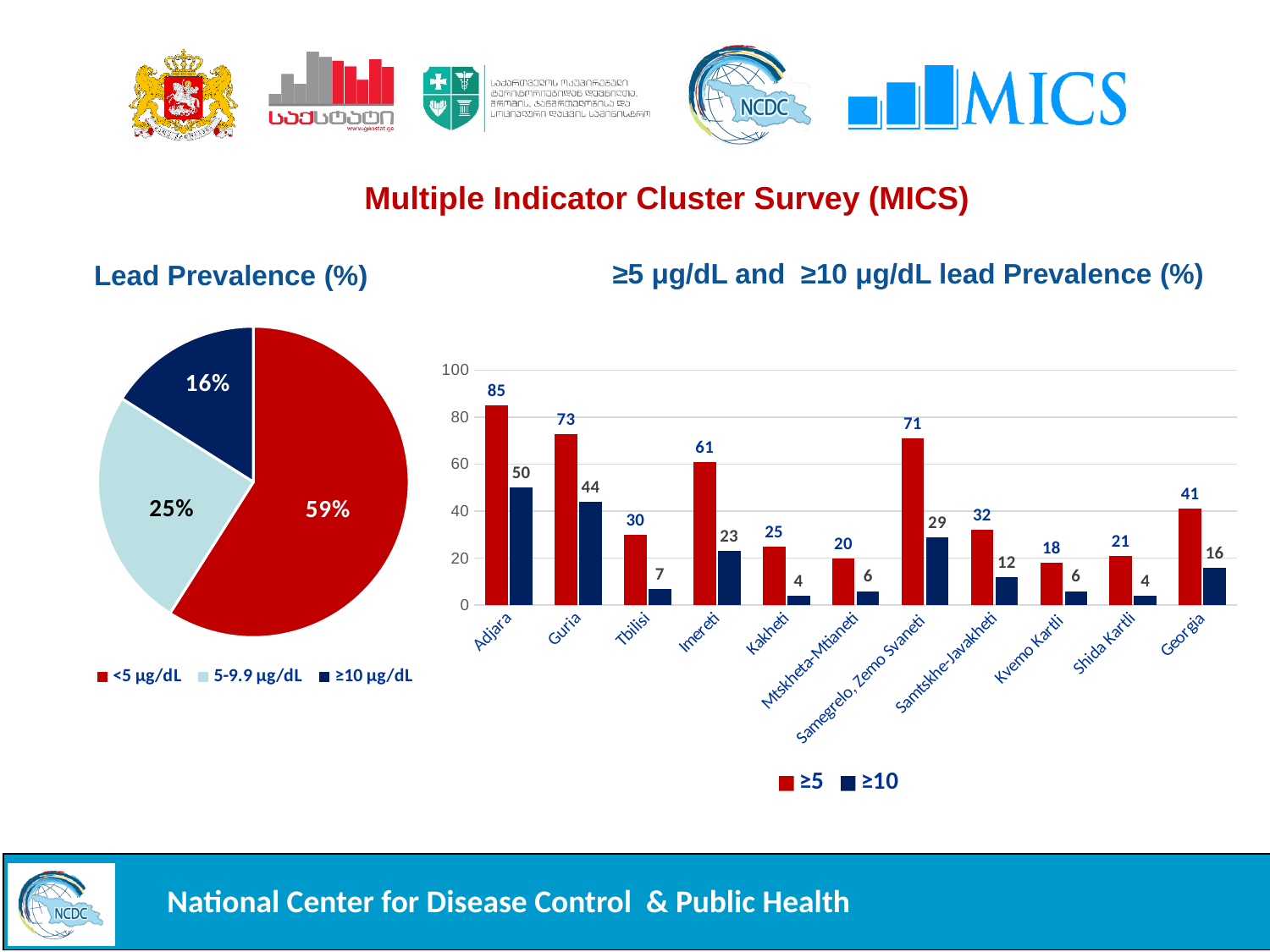
In the '≥5 µg/dL and ≥10 µg/dL lead Prevalence (%)' chart, what is the ≥10 value for Samegrelo, Zemo Svaneti? 29 In the '≥5 µg/dL and ≥10 µg/dL lead Prevalence (%)' chart, what is the ≥5 value for Adjara? 85 In the '≥5 µg/dL and ≥10 µg/dL lead Prevalence (%)' chart, how many regions are shown on the x axis? 11 In the '≥5 µg/dL and ≥10 µg/dL lead Prevalence (%)' chart, which region has the highest ≥5 value? Adjara In the '≥5 µg/dL and ≥10 µg/dL lead Prevalence (%)' chart, how many series does the legend list? 2 In the 'Lead Prevalence (%)' pie chart, what share of the pie is the '<5 µg/dL' slice? 59% What kind of chart is the 'Lead Prevalence (%)' chart on the left? Pie chart In the 'Lead Prevalence (%)' pie chart, what is the value for '≥10 µg/dL'? 16% In the '≥5 µg/dL and ≥10 µg/dL lead Prevalence (%)' chart, which region has the lowest ≥10 value? Kakheti and Shida Kartli (both 4) In the '≥5 µg/dL and ≥10 µg/dL lead Prevalence (%)' chart, what is the difference between the ≥5 and ≥10 values for Guria? 29 In the '≥5 µg/dL and ≥10 µg/dL lead Prevalence (%)' chart, which is larger: the ≥5 value for Imereti or the ≥5 value for Samegrelo, Zemo Svaneti? Samegrelo, Zemo Svaneti In the 'Lead Prevalence (%)' pie chart, how many slices are there? 3